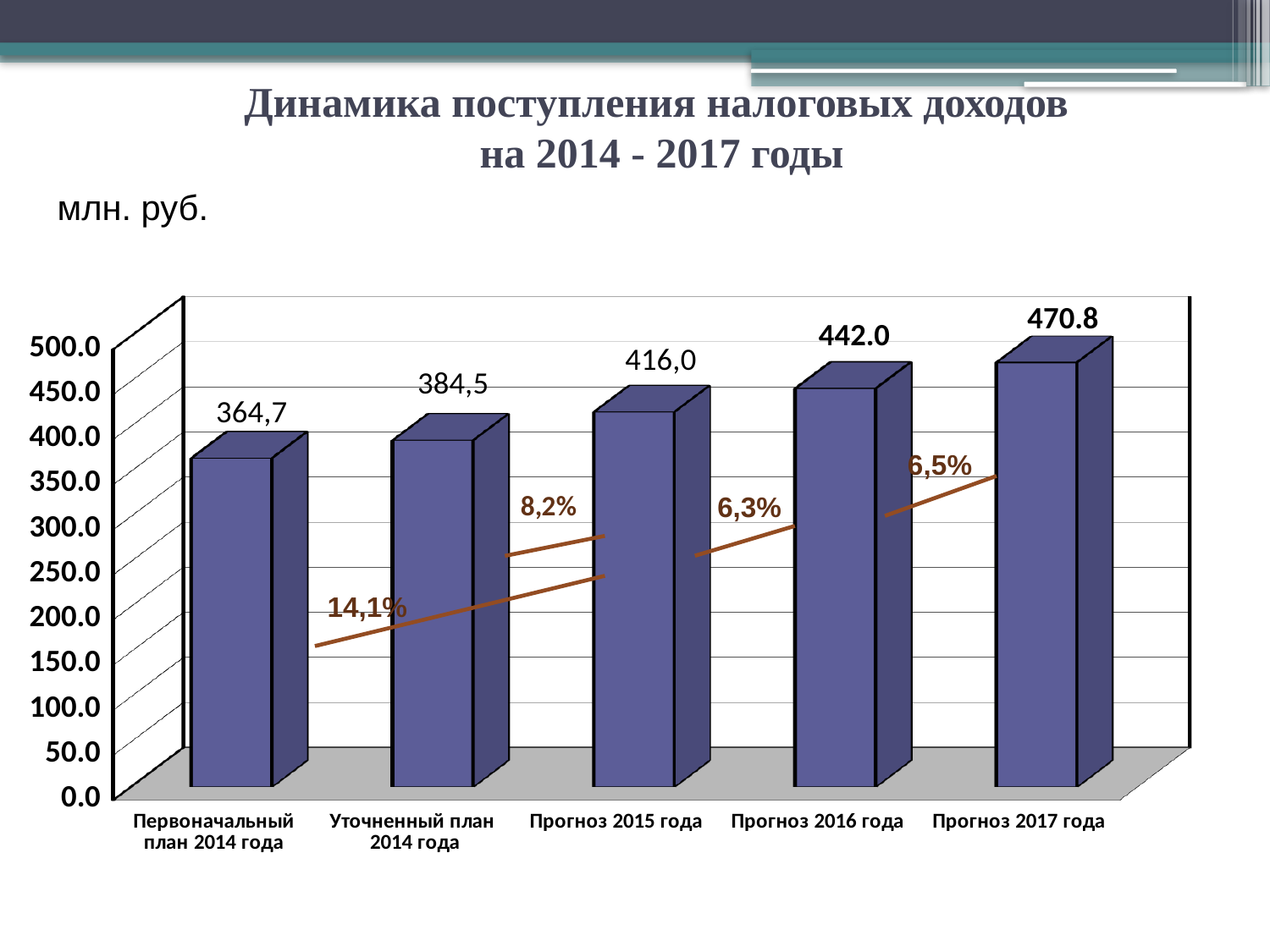
Which category has the highest value? Прогноз 2017 года What is the value for Первоначальный план 2014 года? 364,7 How many categories are shown on the chart? 5 What is the value for Прогноз 2015 года? 416,0 What is the value for Уточненный план 2014 года? 384,5 Which is larger, the value for Прогноз 2015 года or Уточненный план 2014 года? Прогноз 2015 года What is the difference between the values for Прогноз 2017 года and Прогноз 2016 года? 28.8 Which category has the lowest value? Первоначальный план 2014 года What kind of chart is shown on the slide? Bar chart What growth percentage is shown between Первоначальный план 2014 года and Уточненный план 2014 года? 14,1% What is the value for Прогноз 2017 года? 470.8 Do the values rise or fall from left to right along the x axis? Rise